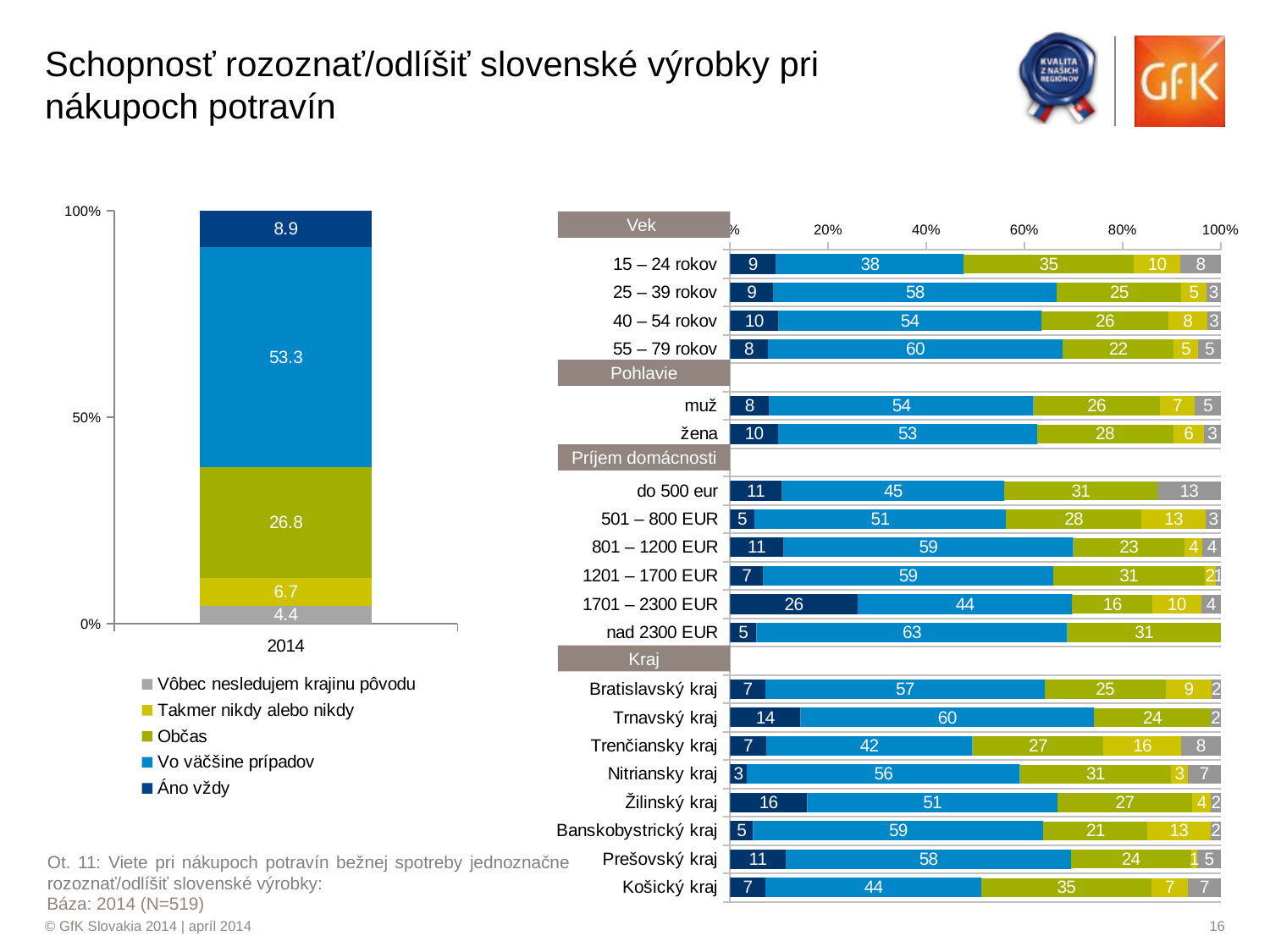
In the right chart, how many age categories are listed under 'Vek'? 4 In the right chart, what is the value of the first (dark blue) segment for '1701 – 2300 EUR'? 26 How many series does the legend of the left chart list? 5 In the left chart, what is the value for 'Áno vždy' in 2014? 8.9 In the right chart, which has the larger first (dark blue) segment: 'Žilinský kraj' or 'Trnavský kraj'? Žilinský kraj In the right chart, what is the value of the second (light blue) segment for '55 – 79 rokov'? 60 What kind of chart is the chart on the right side of the slide? Stacked bar chart In the left chart, what is the difference between the 'Vo väčšine prípadov' segment and the 'Občas' segment? 26.5 In the right chart, what is the value of the third (green) segment for 'Košický kraj'? 35 In the left chart, which legend category has the smallest segment in the 2014 bar? Vôbec nesledujem krajinu pôvodu In the left chart, which legend category has the largest segment in the 2014 bar? Vo väčšine prípadov In the left chart, what is the value for 'Vo väčšine prípadov' in 2014? 53.3